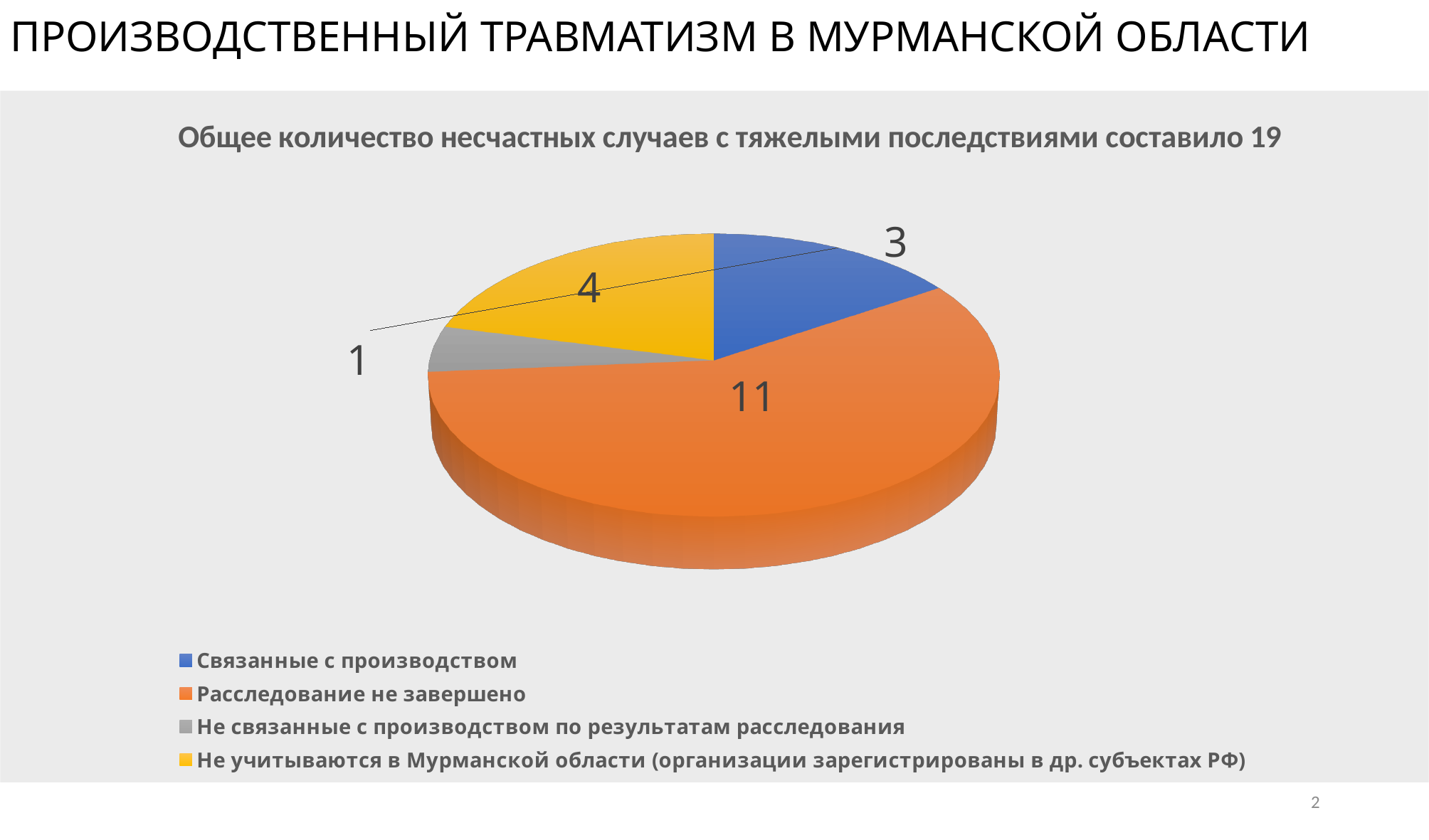
What is the value for "Не учитываются в Мурманской области (организации зарегистрированы в др. субъектах РФ)"? 4 What is the value for "Расследование не завершено"? 11 What is the total of all slices in the pie chart? 19 What colour is the slice for "Расследование не завершено"? Orange Which is larger: the value for "Связанные с производством" or the value for "Не учитываются в Мурманской области (организации зарегистрированы в др. субъектах РФ)"? Не учитываются в Мурманской области (организации зарегистрированы в др. субъектах РФ) How many slices does the pie chart have? 4 Which category has the largest slice of the pie? Расследование не завершено What kind of chart is shown on the slide? Pie chart Which category has the smallest slice of the pie? Не связанные с производством по результатам расследования What is the value for "Связанные с производством"? 3 What is the value for "Не связанные с производством по результатам расследования"? 1 What is the difference between the values for "Расследование не завершено" and "Не учитываются в Мурманской области (организации зарегистрированы в др. субъектах РФ)"? 7